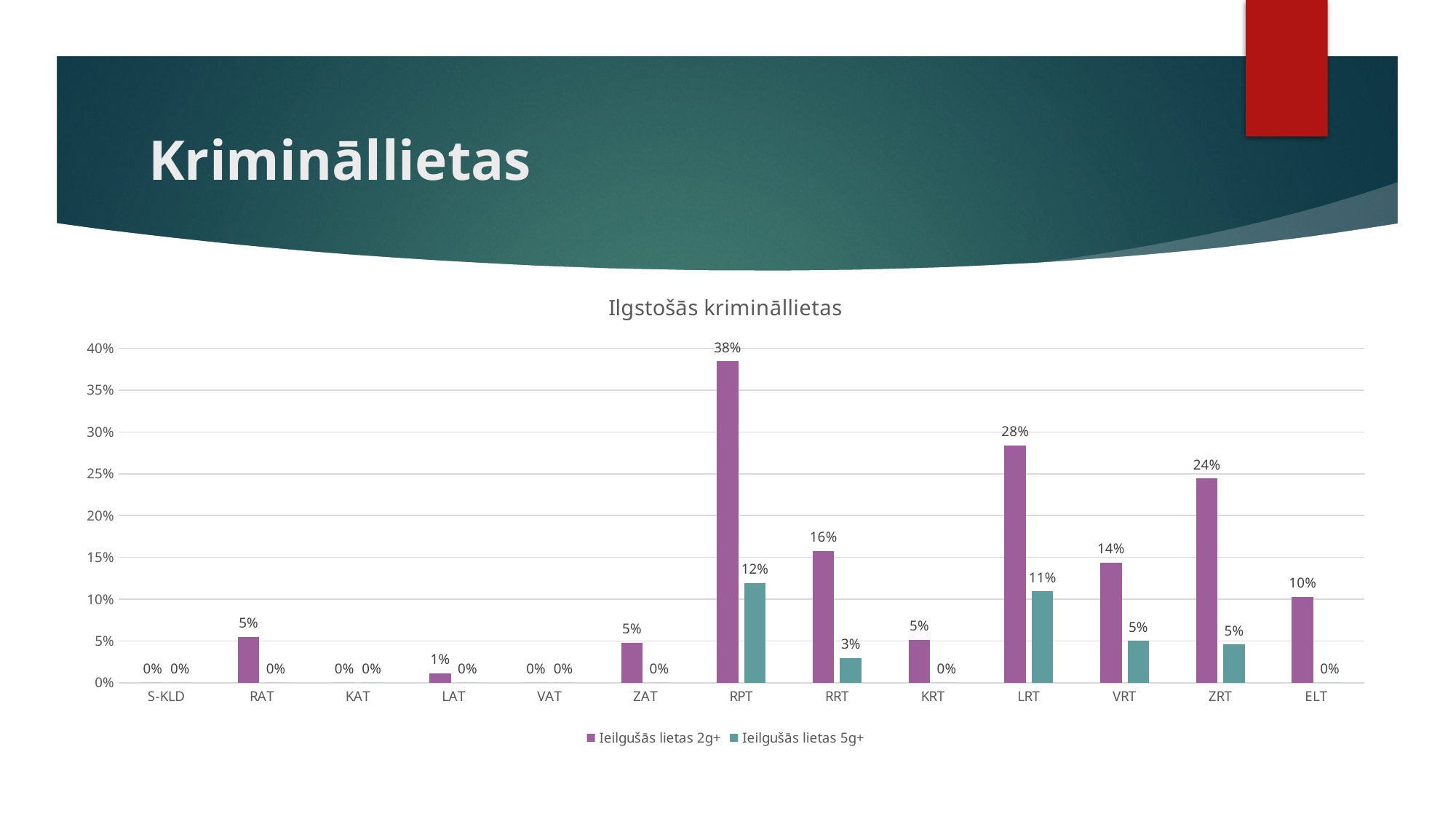
What is the title of the chart? Ilgstošās krimināllietas How many categories are shown on the x axis? 13 What kind of chart is shown on the slide? Bar chart What is the difference between the 'Ieilgušās lietas 2g+' and 'Ieilgušās lietas 5g+' values for RPT? 26% Which category has the highest value in the 'Ieilgušās lietas 2g+' series? RPT What is the difference between the 'Ieilgušās lietas 2g+' values for LRT and ZRT? 4% What is the value for ELT in the 'Ieilgušās lietas 2g+' series? 10% Which is larger: the 'Ieilgušās lietas 2g+' value for RRT or for VRT? RRT What is the value for LRT in the 'Ieilgušās lietas 5g+' series? 11% What is the value for RPT in the 'Ieilgušās lietas 2g+' series? 38% How many series does the legend list? 2 Which category has the highest value in the 'Ieilgušās lietas 5g+' series? RPT